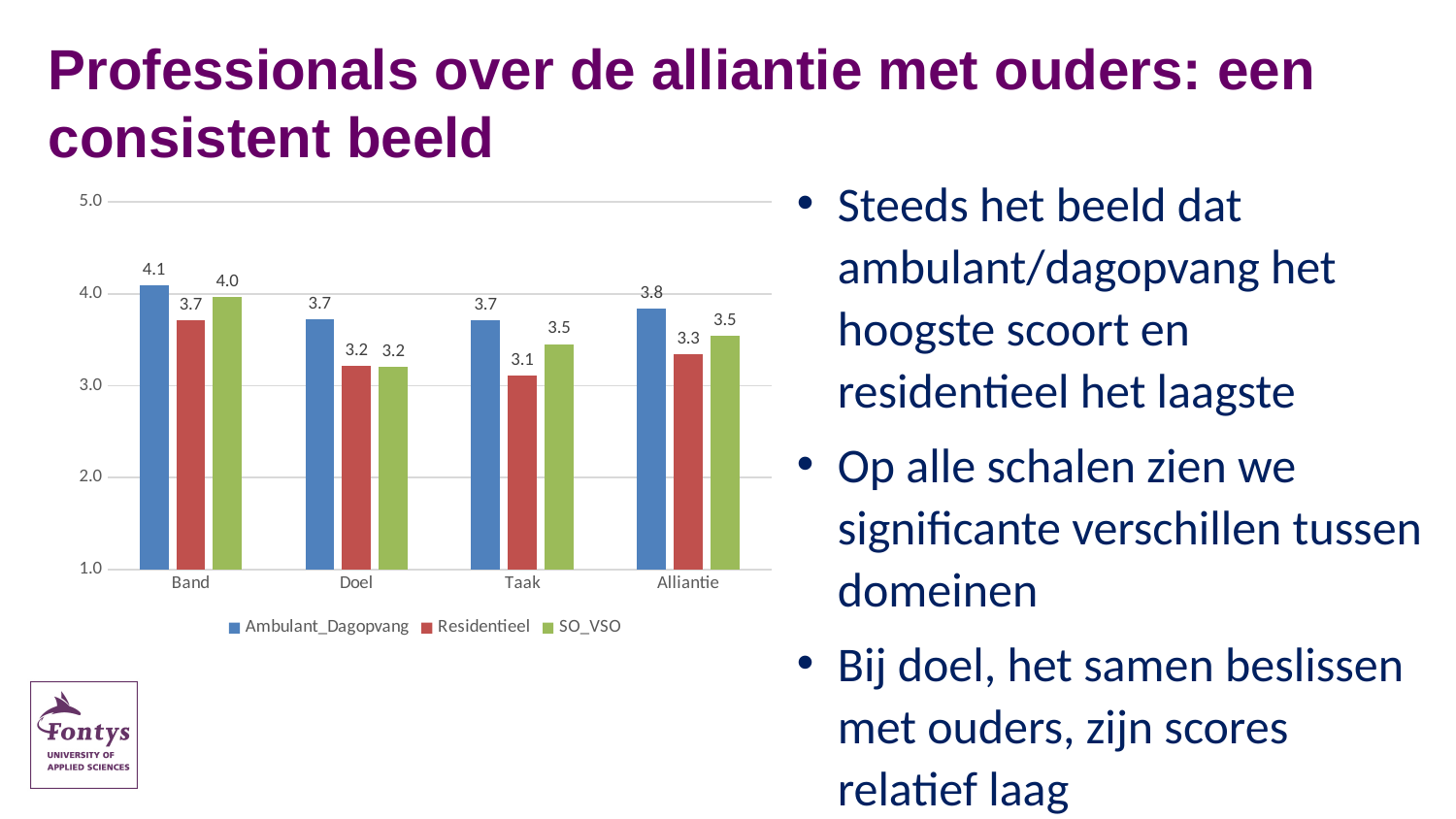
What is the value for SO_VSO in the Alliantie category? 3.5 In which category does Residentieel have its lowest value? Taak What is the difference between the Ambulant_Dagopvang and Residentieel values in the Doel category? 0.5 What is the value for Residentieel in the Taak category? 3.1 Which colour represents the Residentieel series in the chart? red Which is larger in the Taak category: the SO_VSO value or the Residentieel value? SO_VSO Is the value for Residentieel in the Band category greater or less than 3.0? greater In which category does Ambulant_Dagopvang have its highest value? Band What kind of chart is shown on the slide? bar chart What is the value for Ambulant_Dagopvang in the Band category? 4.1 How many categories are shown on the x axis? 4 How many series does the legend list? 3